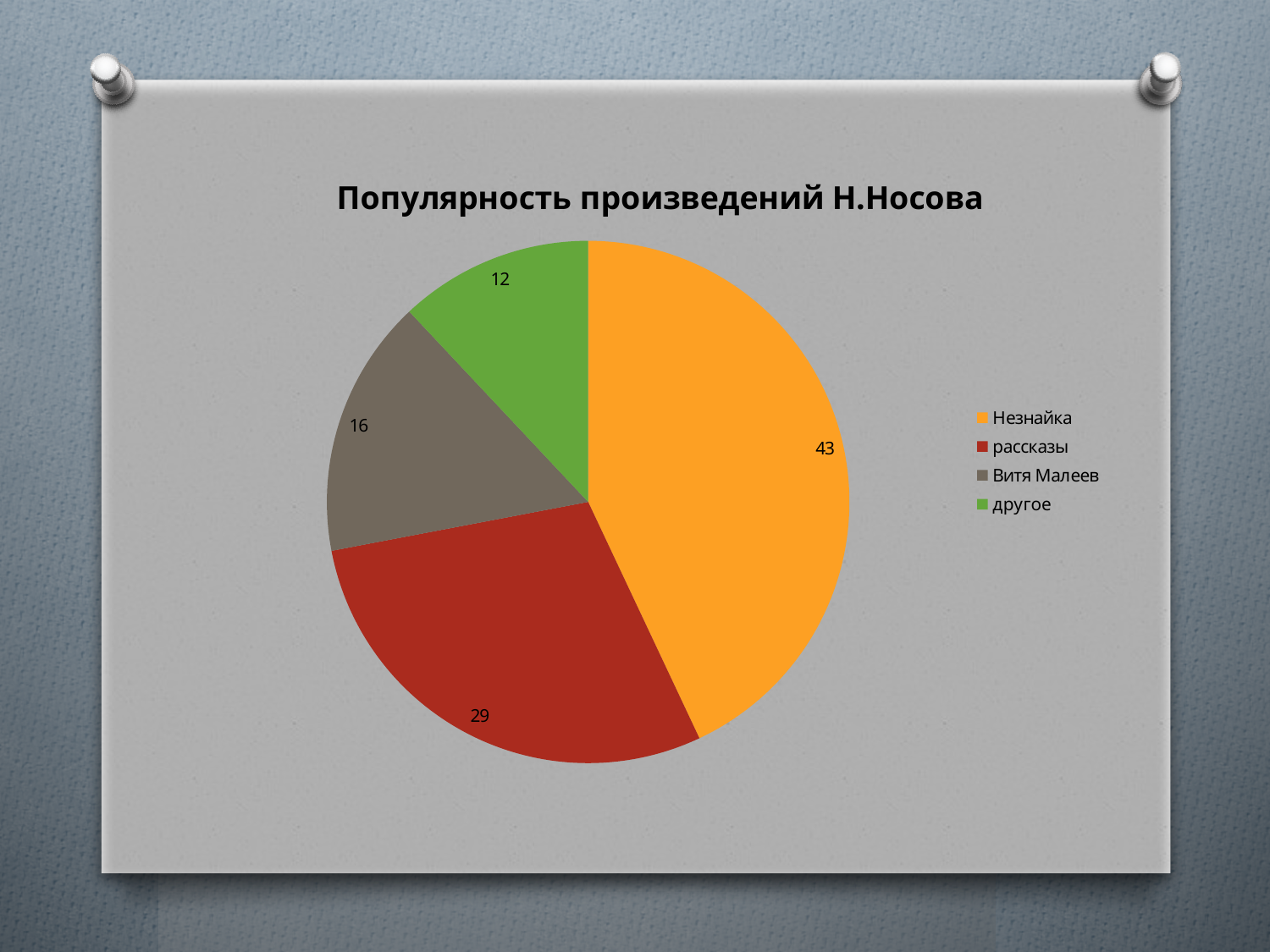
What is the difference between the values for Незнайка and рассказы? 14 Which category has the smallest slice? другое What is the value for Витя Малеев? 16 Which is larger, the value for Витя Малеев or the value for другое? Витя Малеев How many categories does the pie chart show? 4 What is the title of the chart? Популярность произведений Н.Носова Which category has the largest slice? Незнайка What kind of chart is shown on the slide? pie chart What is the value for рассказы? 29 What share of the pie does Незнайка represent? 43% What is the value for другое? 12 What is the value for Незнайка? 43